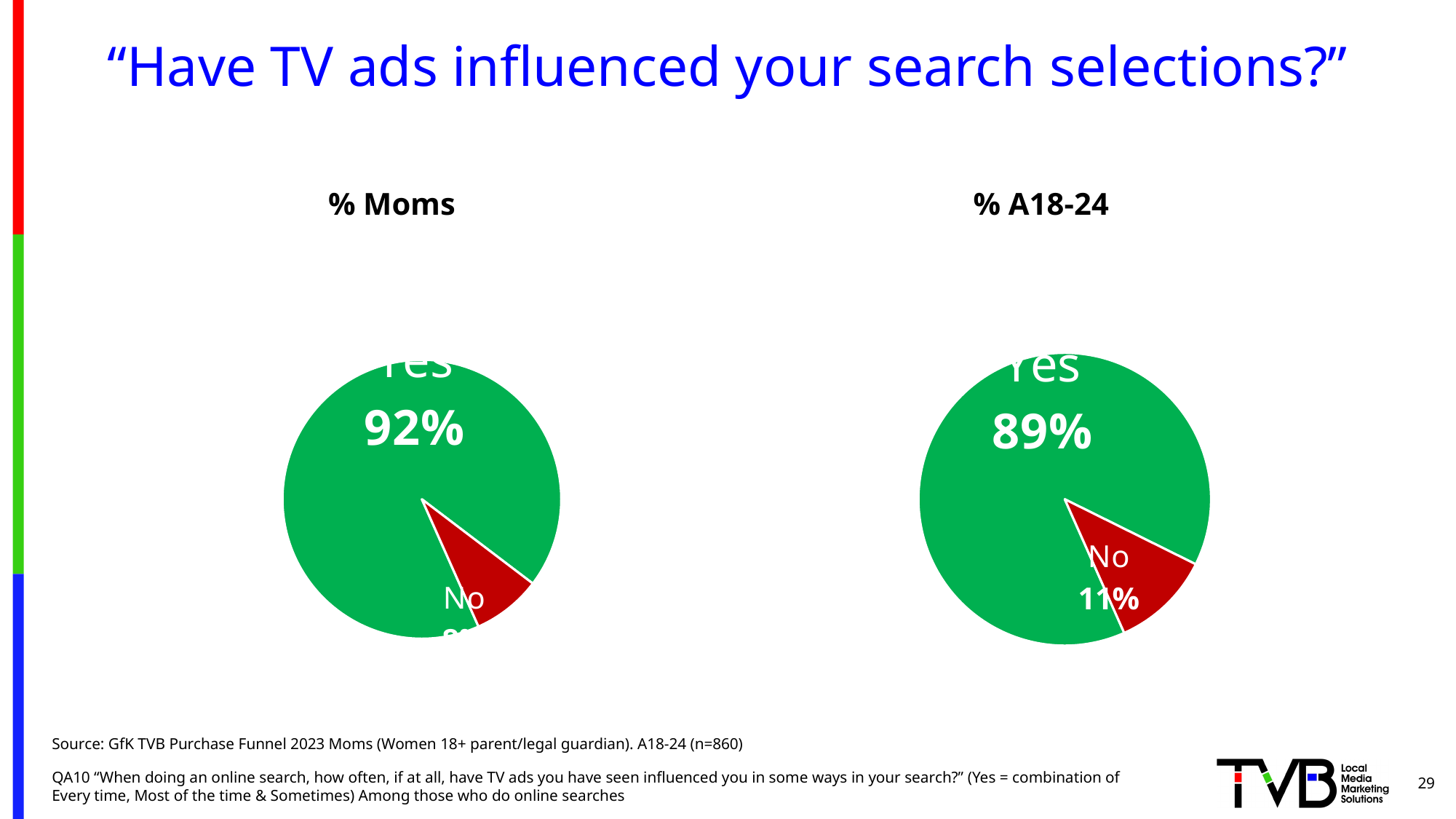
In the % Moms pie chart, is the Yes slice greater or less than 50% of the pie? greater What colour is the No slice in the % A18-24 pie chart? Red In the % A18-24 pie chart, what percentage answered No? 11% In the % Moms pie chart, which response has the largest slice? Yes In the % Moms pie chart, what percentage answered Yes? 92% Which group has a higher Yes percentage, Moms or A18-24? Moms In the % A18-24 pie chart, which response has the smallest slice? No What is the difference between the Yes percentage for Moms and the Yes percentage for A18-24? 3 percentage points In the % A18-24 pie chart, what share of the pie does the No slice represent? 11% How many slices does the % A18-24 pie chart have? 2 In the % A18-24 pie chart, what percentage answered Yes? 89% What kind of chart is used for the % Moms data? Pie chart